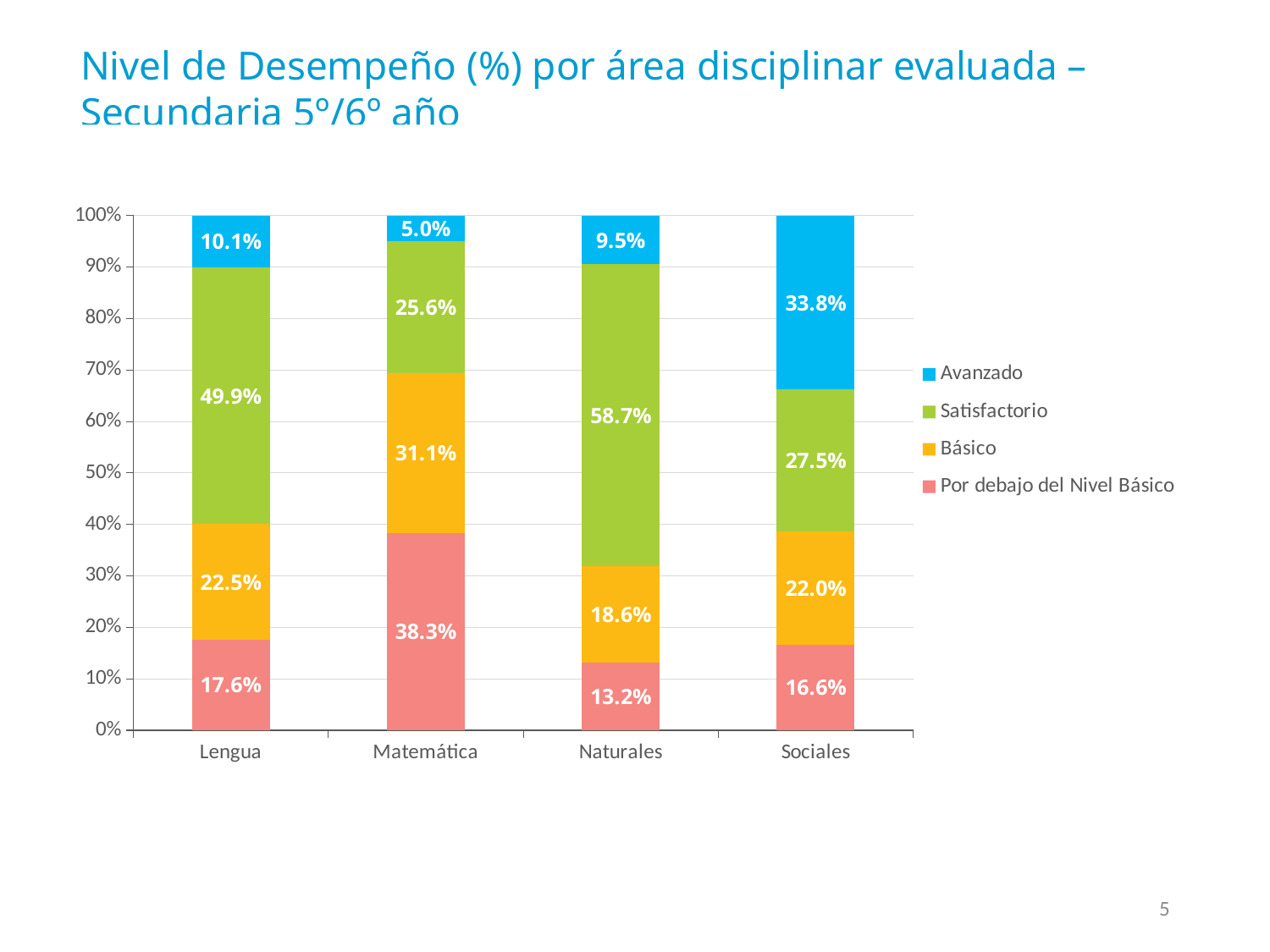
What is the difference between the Satisfactorio values for Naturales and Matemática? 33.1% How many areas are shown on the x axis? 4 What is the Por debajo del Nivel Básico value for Matemática? 38.3% What is the Satisfactorio value for Naturales? 58.7% What is the Básico value for Lengua? 22.5% Which area has the highest Avanzado value? Sociales Which area has the lowest Por debajo del Nivel Básico value? Naturales Which is larger, the Básico value for Matemática or the Básico value for Sociales? Matemática What kind of chart is this? Stacked bar chart What is the Avanzado value for Sociales? 33.8% Which legend entry is shown in blue? Avanzado How many series does the legend list? 4